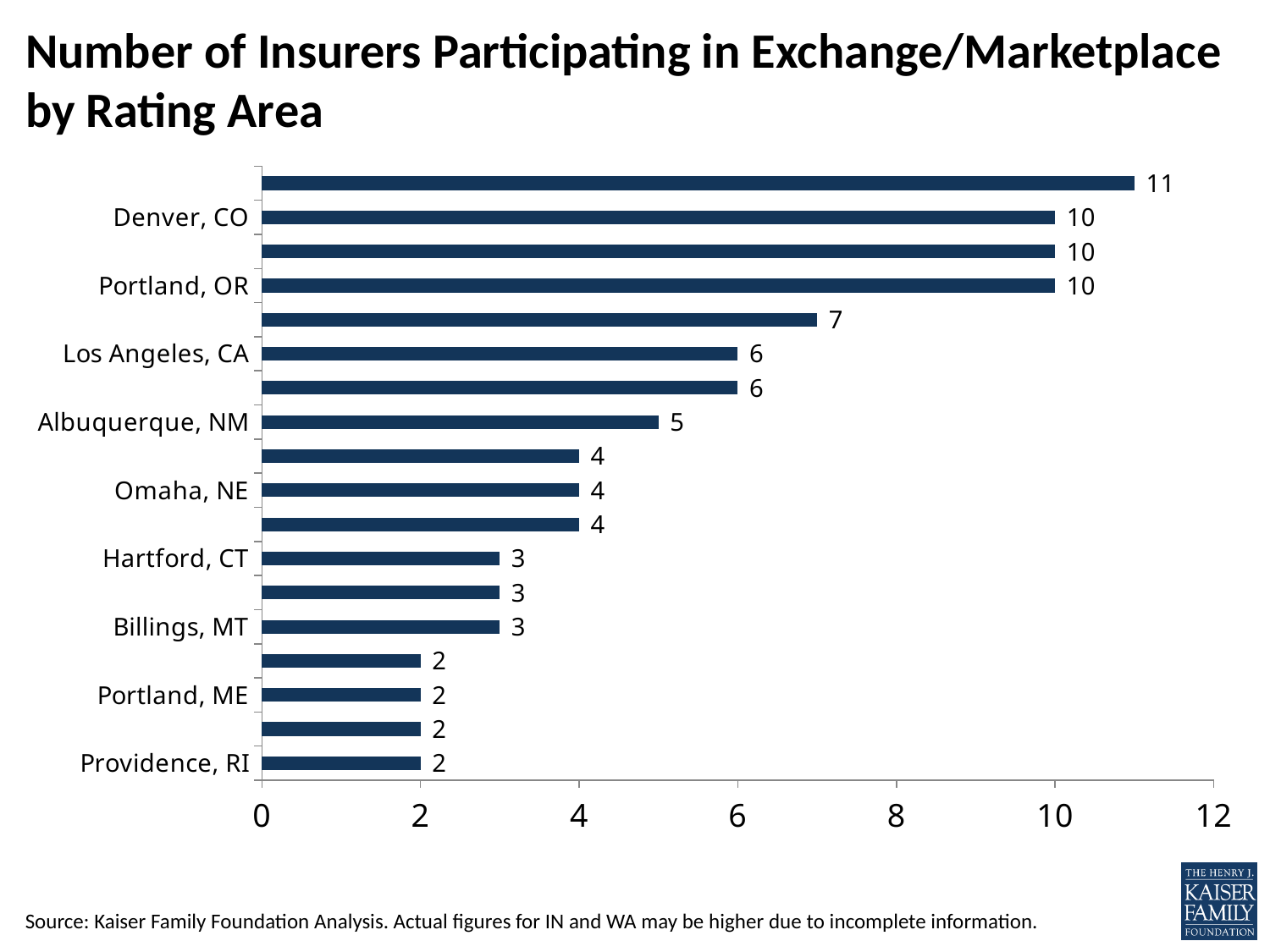
Do the values rise or fall going from the top bar to the bottom bar? fall How many bars are plotted in the chart? 18 What is the value for Albuquerque, NM? 5 What is the title of the chart? Number of Insurers Participating in Exchange/Marketplace by Rating Area Which has more participating insurers, Los Angeles, CA or Billings, MT? Los Angeles, CA What is the difference between the values for Denver, CO and Omaha, NE? 6 How many insurers participate in the exchange/marketplace in Denver, CO? 10 How many insurers participate in Providence, RI? 2 What is the value for Los Angeles, CA? 6 What type of chart is shown on the slide? bar chart What is the value for Hartford, CT? 3 What is the difference between the values for Portland, OR and Portland, ME? 8